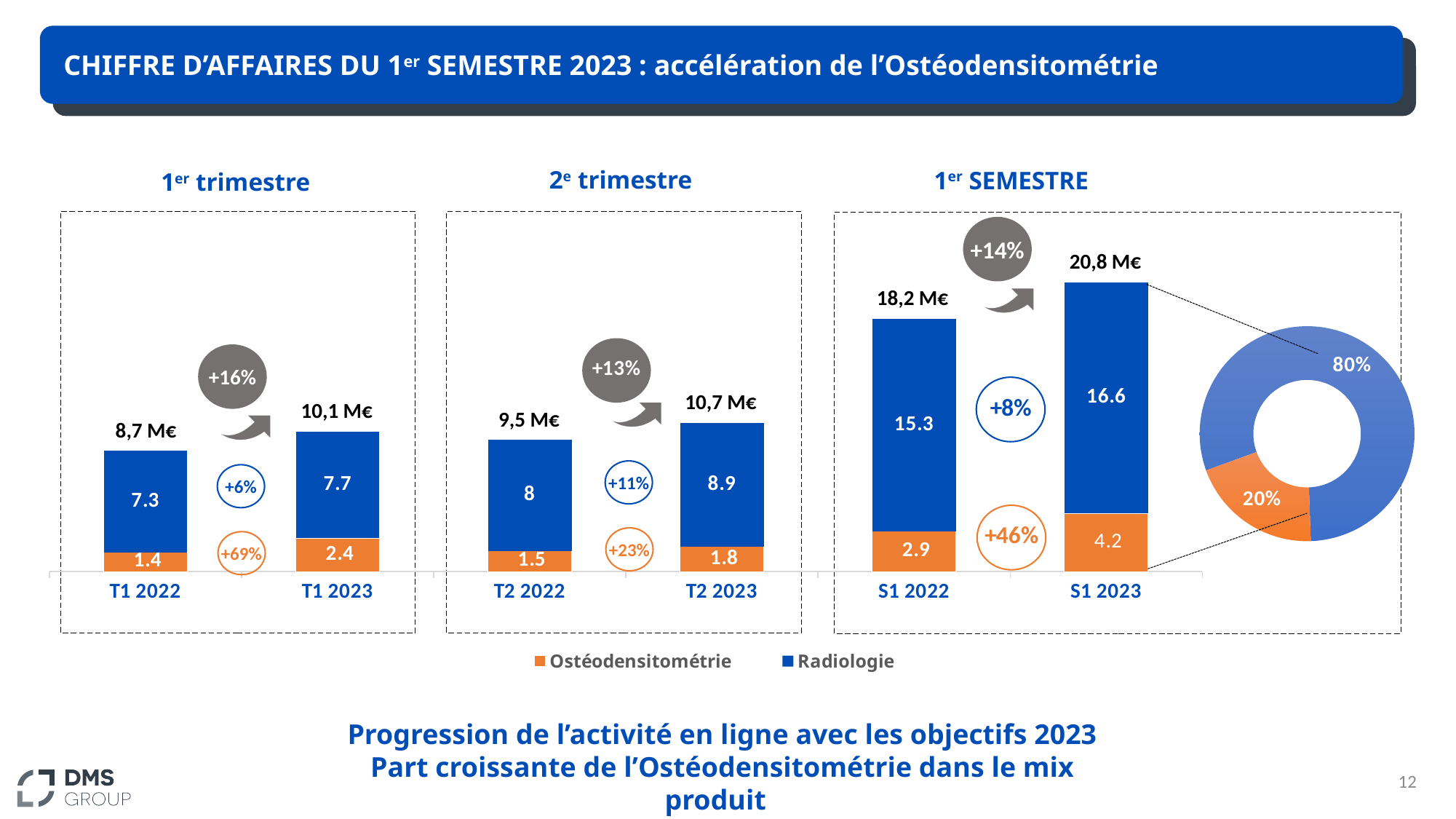
In the donut chart on the right, what share does Ostéodensitométrie represent? 20% In the 1er SEMESTRE chart, what is the total revenue shown above the S1 2022 bar? 18,2 M€ In the donut chart on the right, what share does Radiologie represent? 80% In the 1er SEMESTRE chart, what is the difference between the Radiologie values for S1 2023 and S1 2022? 1.3 How many series does the legend list for the bar charts? 2 What kind of chart is used for the 1er SEMESTRE comparison of S1 2022 and S1 2023? Stacked bar chart In the 1er trimestre chart, what is the Radiologie value for T1 2023? 7.7 In the 1er trimestre chart, what is the percentage growth shown for Ostéodensitométrie between T1 2022 and T1 2023? +69% In the 1er trimestre chart, what is the Ostéodensitométrie value for T1 2022? 1.4 In the 1er SEMESTRE chart, what is the Ostéodensitométrie value for S1 2023? 4.2 In the 2e trimestre chart, what is the total revenue shown above the T2 2023 bar? 10,7 M€ In the 2e trimestre chart, which bar has the higher Radiologie value, T2 2022 or T2 2023? T2 2023